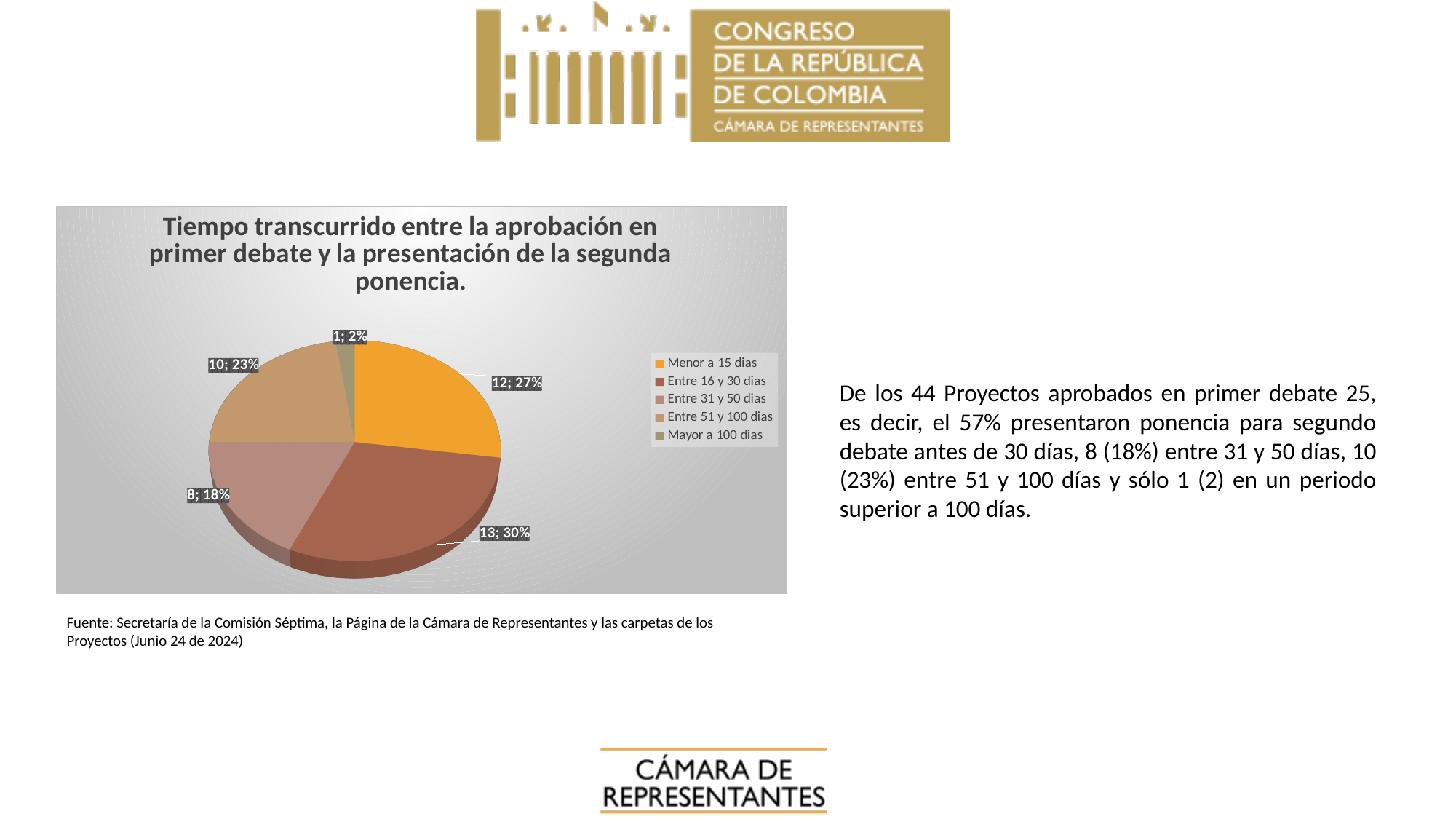
How many categories does the pie chart show? 5 What is the value for 'Mayor a 100 dias' in the pie chart? 1 What is the difference between the values for 'Entre 51 y 100 dias' and 'Entre 31 y 50 dias'? 2 Which category has the smallest slice in the pie chart? Mayor a 100 dias What share of the pie does 'Entre 51 y 100 dias' represent? 23% What is the value for 'Entre 16 y 30 dias' in the pie chart? 13 What is the value for 'Menor a 15 dias' in the pie chart? 12 What kind of chart is shown on the slide? Pie chart Which category has the largest slice in the pie chart? Entre 16 y 30 dias How many entries does the legend of the pie chart list? 5 What is the value for 'Entre 31 y 50 dias' in the pie chart? 8 What is the title of the pie chart? Tiempo transcurrido entre la aprobación en primer debate y la presentación de la segunda ponencia.